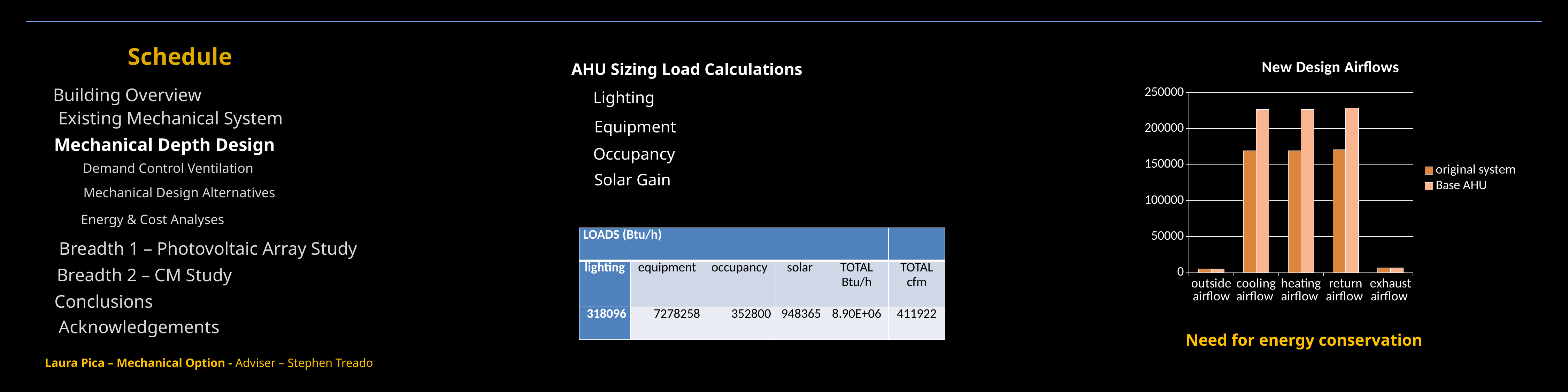
Is the Base AHU value for return airflow greater or less than 200000? greater What are the two series named in the chart's legend? original system, Base AHU Is the original system value for exhaust airflow greater or less than 50000? less Is the original system value for heating airflow greater or less than 150000? greater What is the title of the chart on the slide? New Design Airflows For the original system series, which is larger, cooling airflow or outside airflow? cooling airflow What kind of chart is shown on the slide? bar chart For cooling airflow, which series has the larger value, original system or Base AHU? Base AHU How many series does the chart's legend list? 2 How many airflow categories are shown on the x axis of the chart? 5